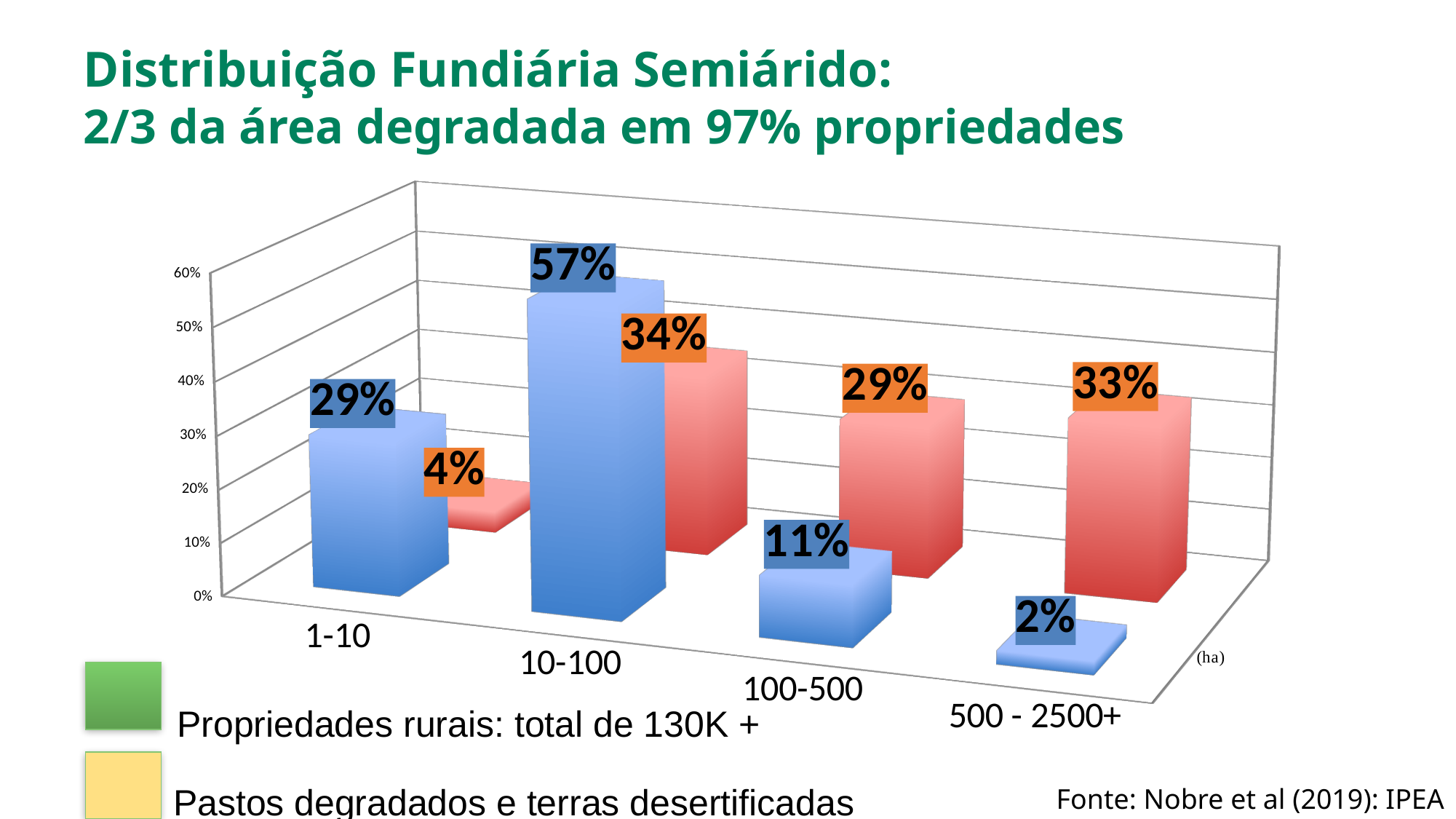
In the 100-500 category, which is larger: the blue bar or the red bar? The red bar What is the value of the blue bar for the 500 - 2500+ category? 2% Which category has the highest blue bar? 10-100 What is the value of the red bar for the 1-10 category? 4% What are the two legend entries shown below the chart? Propriedades rurais: total de 130K + and Pastos degradados e terras desertificadas What is the value of the red bar for the 500 - 2500+ category? 33% In the 10-100 category, what is the difference between the blue bar (57%) and the red bar (34%)? 23 percentage points How many size categories (in ha) are shown on the x axis? 4 What kind of chart is shown on the slide? Bar chart In the 1-10 category, what is the difference between the blue bar (29%) and the red bar (4%)? 25 percentage points What is the value of the blue bar for the 10-100 category? 57% Which category has the lowest red bar? 1-10